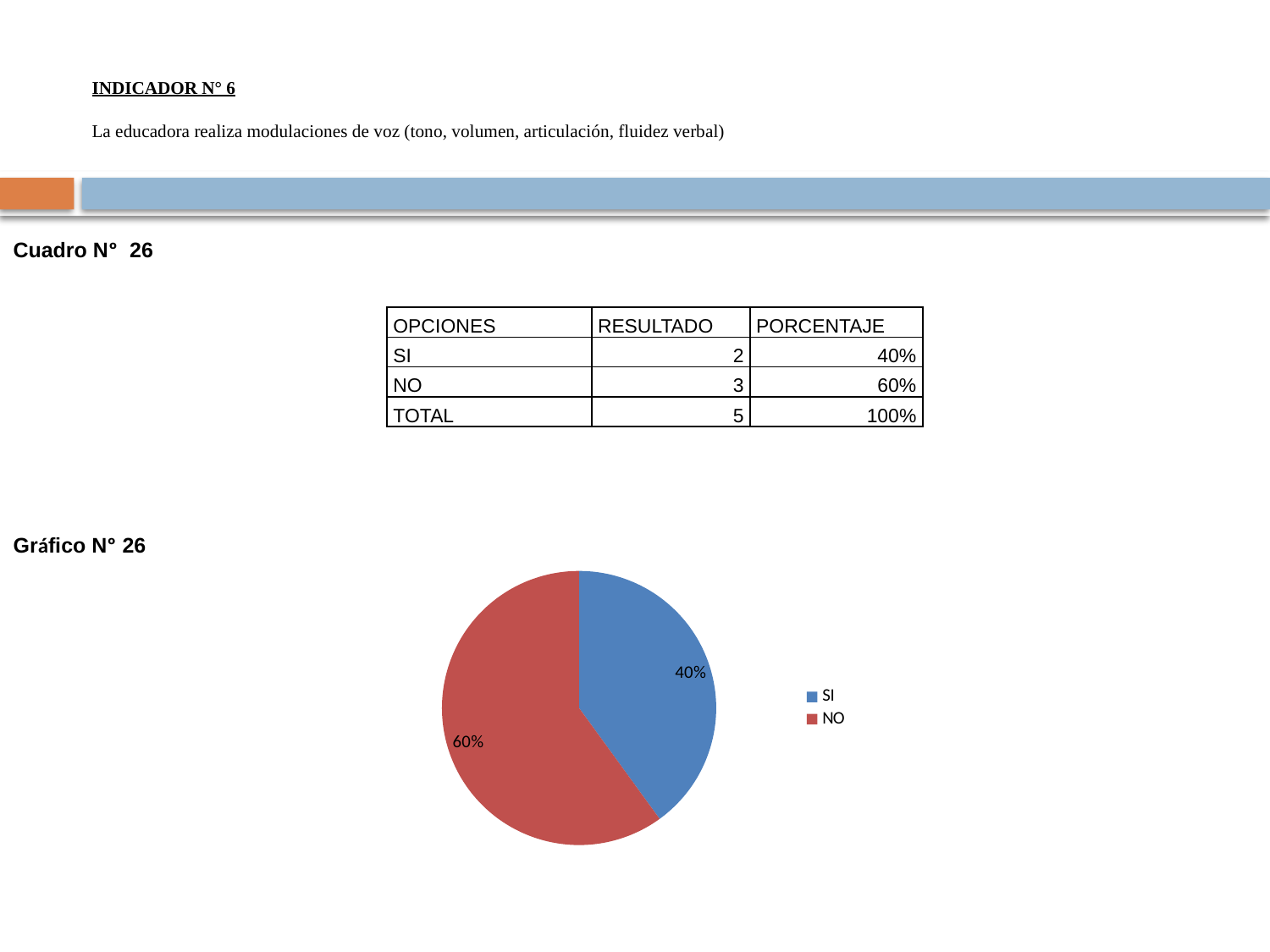
What colour is the SI slice in the pie chart? blue Which slice is larger, SI or NO? NO What is the difference in percentage points between the NO slice and the SI slice? 20% What percentage does the NO slice show in the pie chart? 60% Which category has the largest slice in the pie chart? NO What kind of chart is shown on the slide? pie chart What percentage does the SI slice show in the pie chart? 40% What share of the pie does the NO slice represent? 60% What is the label of the chart shown on the slide? Gráfico N° 26 How many entries does the legend of the pie chart list? 2 How many slices does the pie chart have? 2 Which category has the smallest slice in the pie chart? SI